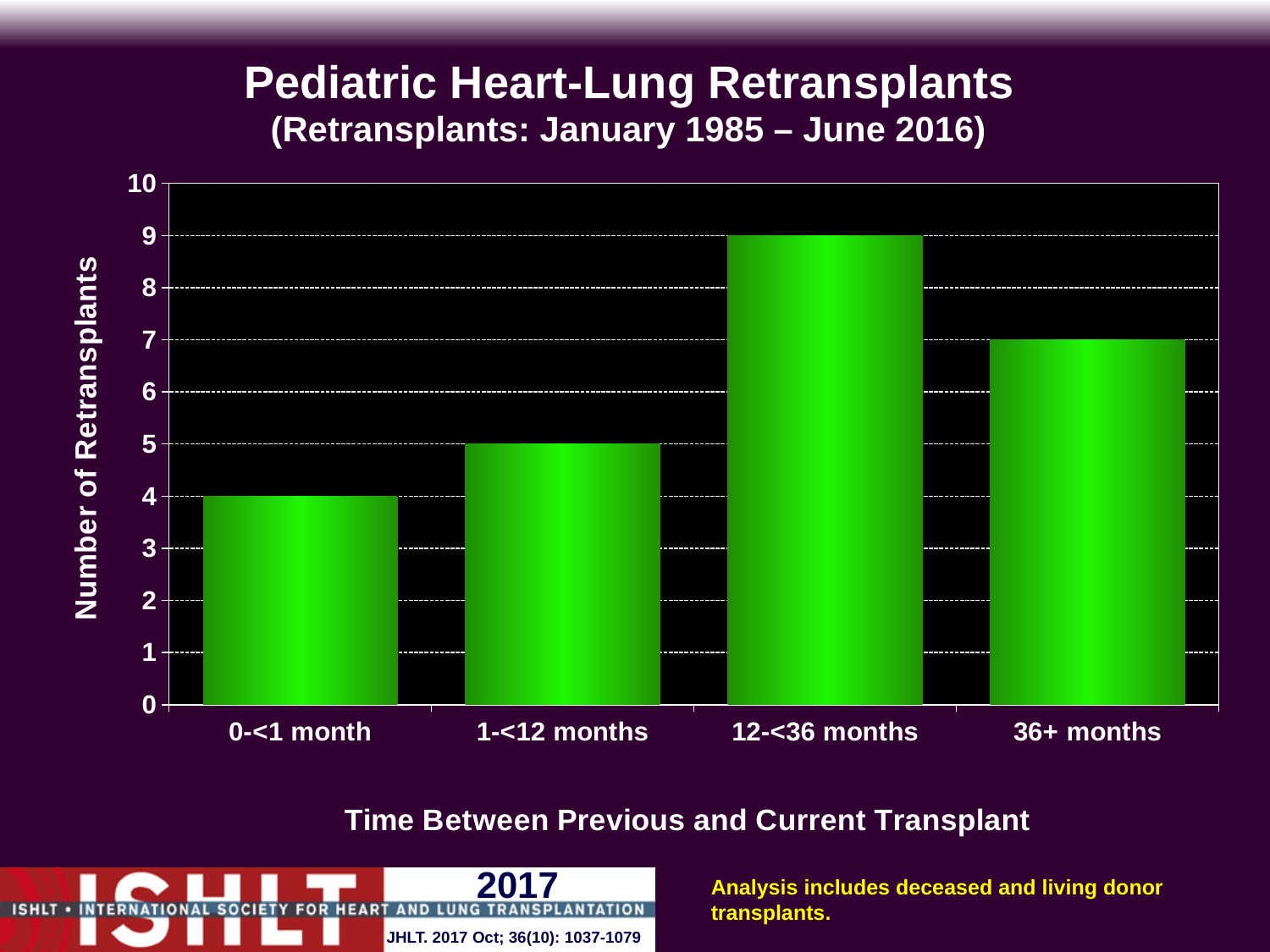
Which time-between-transplants category has the highest number of retransplants? 12-<36 months What kind of chart is shown on the slide? bar chart What is the difference in number of retransplants between the 12-<36 months and 36+ months categories? 2 What is the number of retransplants for the 0-<1 month category? 4 Which has more retransplants, the 1-<12 months category or the 36+ months category? 36+ months What is the number of retransplants for the 1-<12 months category? 5 What is the number of retransplants for the 12-<36 months category? 9 What is the number of retransplants for the 36+ months category? 7 How many time-between-transplants categories are shown on the x axis? 4 Which time-between-transplants category has the lowest number of retransplants? 0-<1 month Is the number of retransplants for the 12-<36 months category greater or less than 8? greater What is the label of the y axis? Number of Retransplants